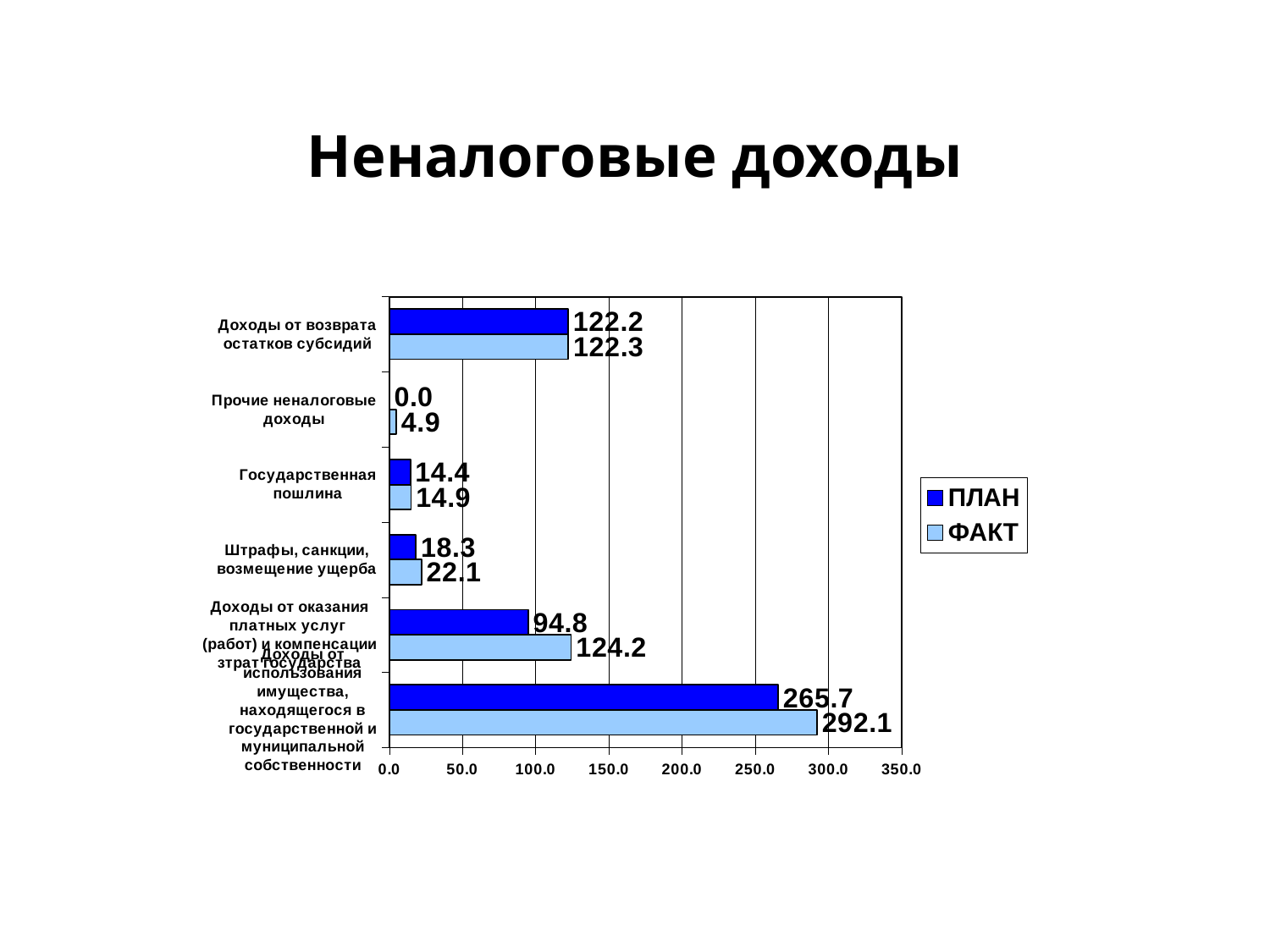
What is the ФАКТ value for Доходы от возврата остатков субсидий? 122.3 What is the ФАКТ value for Штрафы, санкции, возмещение ущерба? 22.1 What is the ПЛАН value for Прочие неналоговые доходы? 0.0 What is the difference between the ФАКТ and ПЛАН values for Доходы от использования имущества, находящегося в государственной и муниципальной собственности? 26.4 What is the difference between the ФАКТ and ПЛАН values for Доходы от оказания платных услуг (работ) и компенсации затрат государства? 29.4 What is the ПЛАН value for Государственная пошлина? 14.4 Which is larger for Штрафы, санкции, возмещение ущерба: the ПЛАН value or the ФАКТ value? ФАКТ Which category has the highest ФАКТ value? Доходы от использования имущества, находящегося в государственной и муниципальной собственности Which category has the lowest ПЛАН value? Прочие неналоговые доходы What type of chart is shown on the slide? Bar chart How many categories are shown on the chart? 6 How many series does the legend list? 2